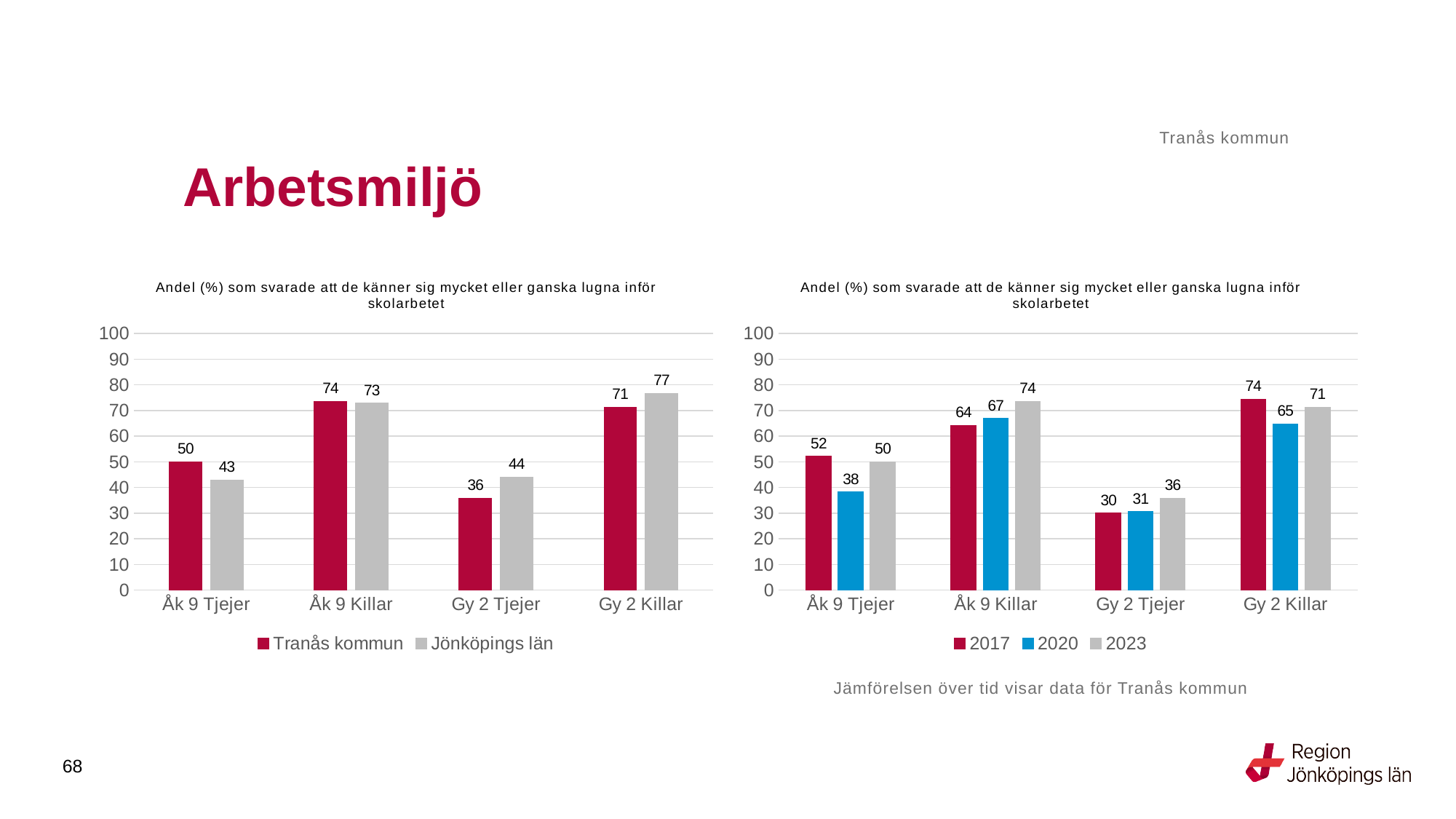
In the right chart, how many series does the legend list? 3 In the right chart, what is the value for 2017 for Gy 2 Killar? 74 In the left chart, what is the value for Jönköpings län for Gy 2 Killar? 77 In the right chart, which category has the highest value for 2023? Åk 9 Killar In the left chart, what is the value for Tranås kommun for Åk 9 Tjejer? 50 In the left chart, which category has the lowest value for Tranås kommun? Gy 2 Tjejer What kind of chart is the right chart? bar chart In the right chart, is the value for 2017 for Åk 9 Killar larger or smaller than the value for 2020 for Åk 9 Killar? smaller In the left chart, what is the difference between Jönköpings län and Tranås kommun for Gy 2 Tjejer? 8 In the right chart, what is the value for 2020 for Åk 9 Tjejer? 38 In the right chart, what is the difference between the 2017 and 2020 values for Gy 2 Killar? 9 In the left chart, how many series does the legend list? 2